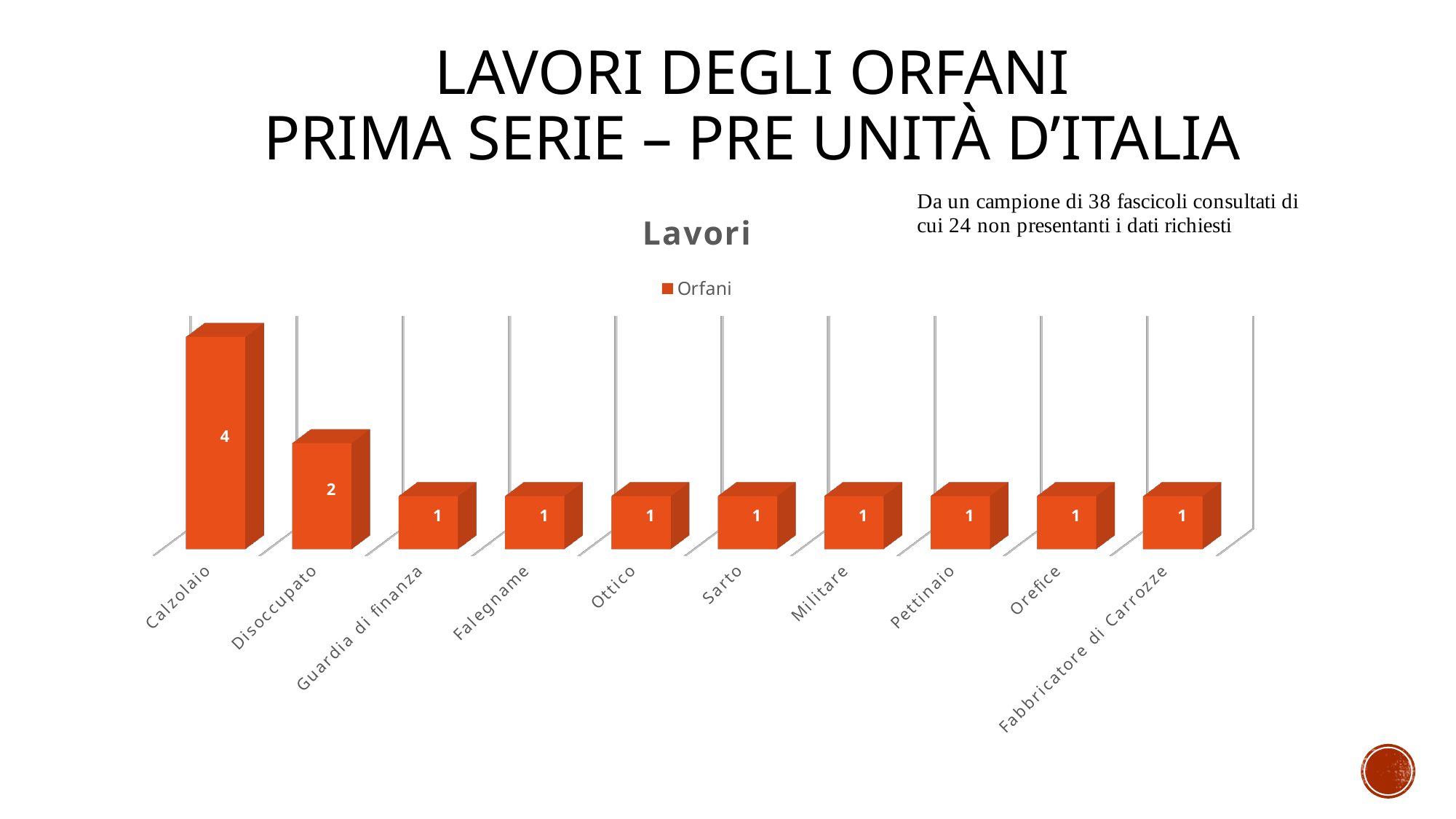
What kind of chart is shown? bar chart What is the value for Falegname? 1 How many categories are shown on the x axis? 10 What is the value for Fabbricatore di Carrozze? 1 How many series does the legend list? 1 What is the difference between the values for Calzolaio and Disoccupato? 2 Which category has the highest value? Calzolaio What is the title of the chart? Lavori What is the value for Disoccupato? 2 What is the difference between the values for Disoccupato and Sarto? 1 Which is larger, the value for Calzolaio or the value for Orefice? Calzolaio What is the value for Calzolaio? 4